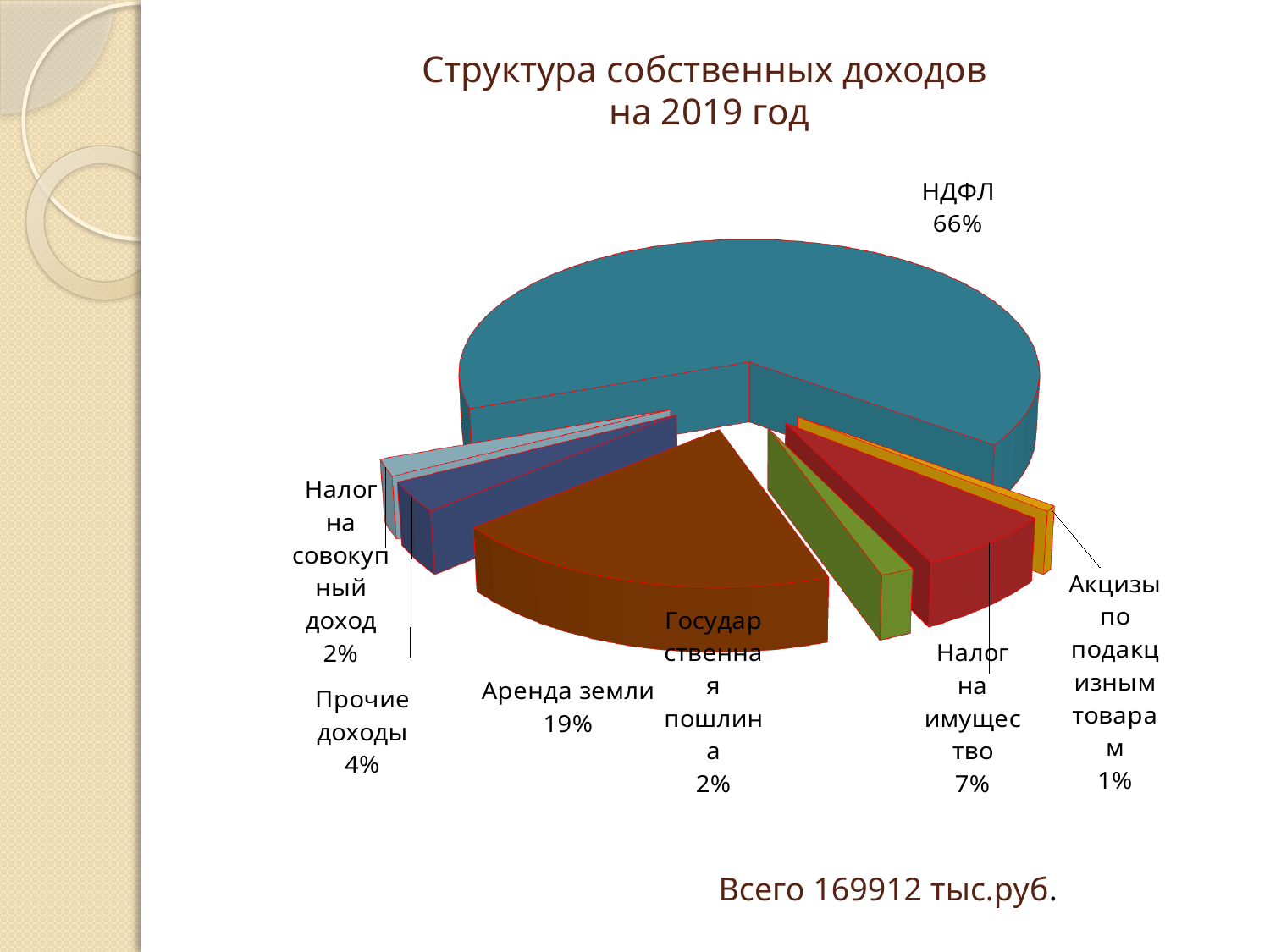
How many slices does the pie chart have? 7 What percentage is shown for Налог на имущество? 7% What is the title of the chart? Структура собственных доходов на 2019 год Which category has the largest share of the pie? НДФЛ What share of the pie does НДФЛ account for? 66% What is the value shown for Аренда земли? 19% What kind of chart is shown on the slide? Pie chart What is the difference in percentage points between НДФЛ and Аренда земли? 47 Which is larger, the share for Налог на имущество or the share for Прочие доходы? Налог на имущество Which category has the smallest share of the pie? Акцизы по подакцизным товарам What percentage is shown for Прочие доходы? 4% What percentage is shown for Акцизы по подакцизным товарам? 1%